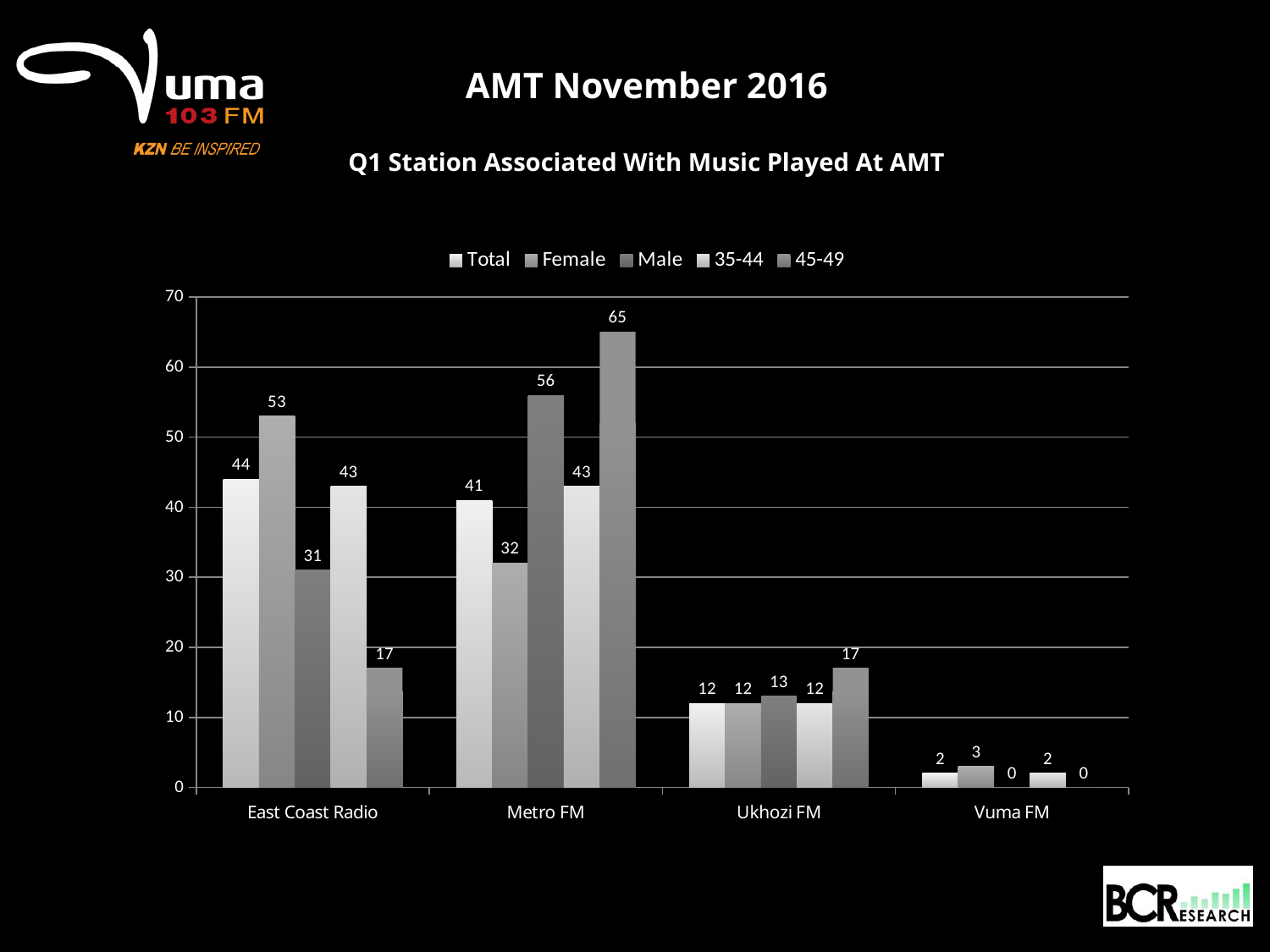
What is the 45-49 value for Metro FM? 65 How many stations are shown on the x axis? 4 What is the difference between the Female value for East Coast Radio and the Female value for Metro FM? 21 What is the Total value for East Coast Radio? 44 Which is larger, the Total value for East Coast Radio or the Total value for Metro FM? East Coast Radio What is the Female value for Vuma FM? 3 Which station has the highest Male value? Metro FM What is the Male value for Ukhozi FM? 13 How many series does the legend list? 5 What is the title of the chart? Q1 Station Associated With Music Played At AMT What kind of chart is shown on the slide? Bar chart Which station has the lowest Total value? Vuma FM